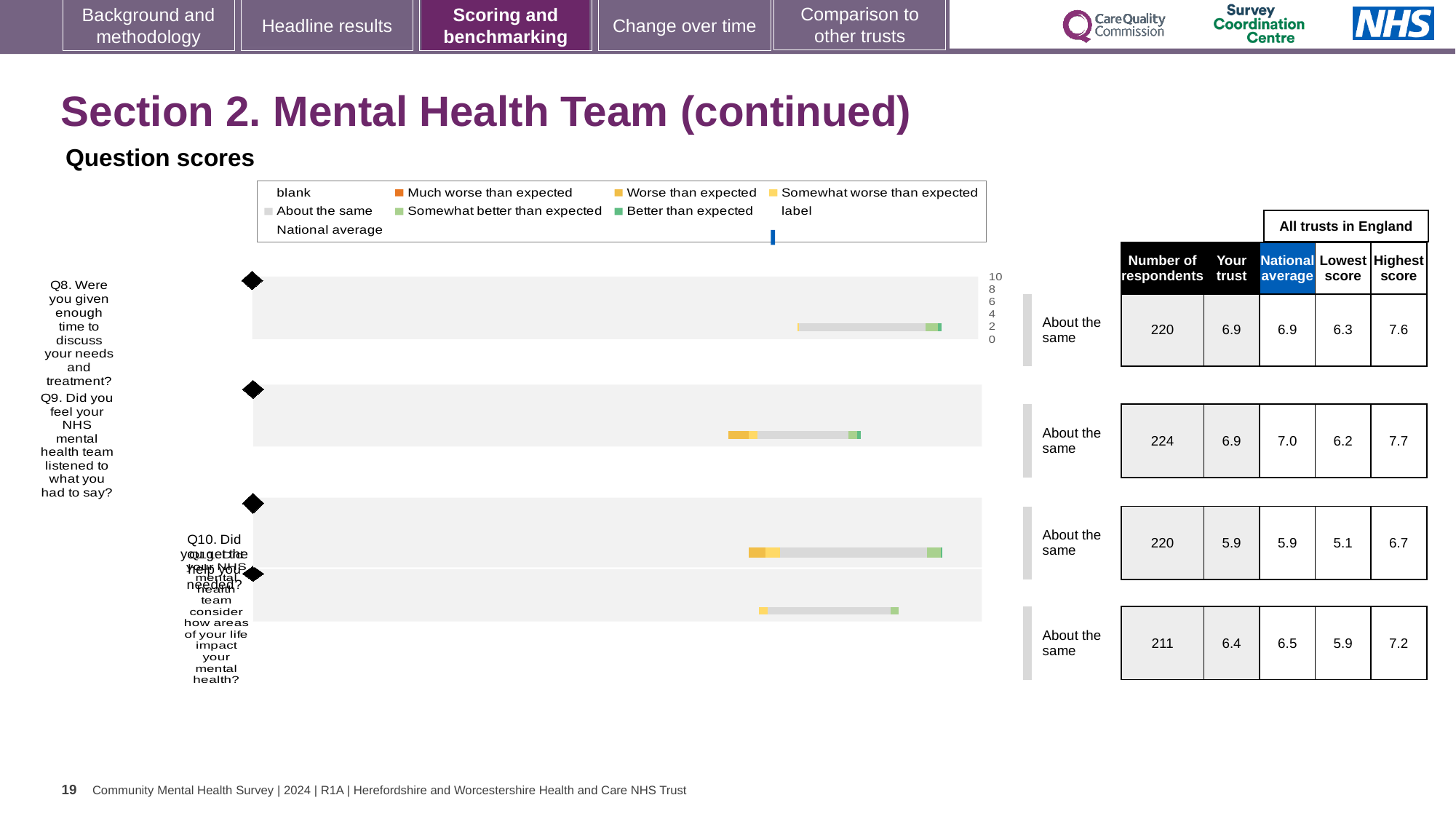
What is the lowest score among all trusts in England for Q10 (Did you get the help you needed?)? 5.1 Which question has the lowest 'Your trust' score? Q10 For the bottom row (211 respondents), which is larger: the 'Your trust' score or the national average? National average What is the 'Your trust' score for Q8 (Were you given enough time to discuss your needs and treatment?)? 6.9 What benchmark category is shown next to each of the four questions? About the same How many questions (bars) are shown in the question scores chart? 4 What is the national average score for Q9 (Did you feel your NHS mental health team listened to what you had to say?)? 7.0 What kind of chart is used to show the question scores on this slide? bar chart How many respondents answered Q9? 224 What is the difference between the highest score (7.6) and the lowest score (6.3) for Q8? 1.3 Which question has the highest 'Highest score' across all trusts in England? Q9 What colour represents 'Better than expected' in the chart legend? Green